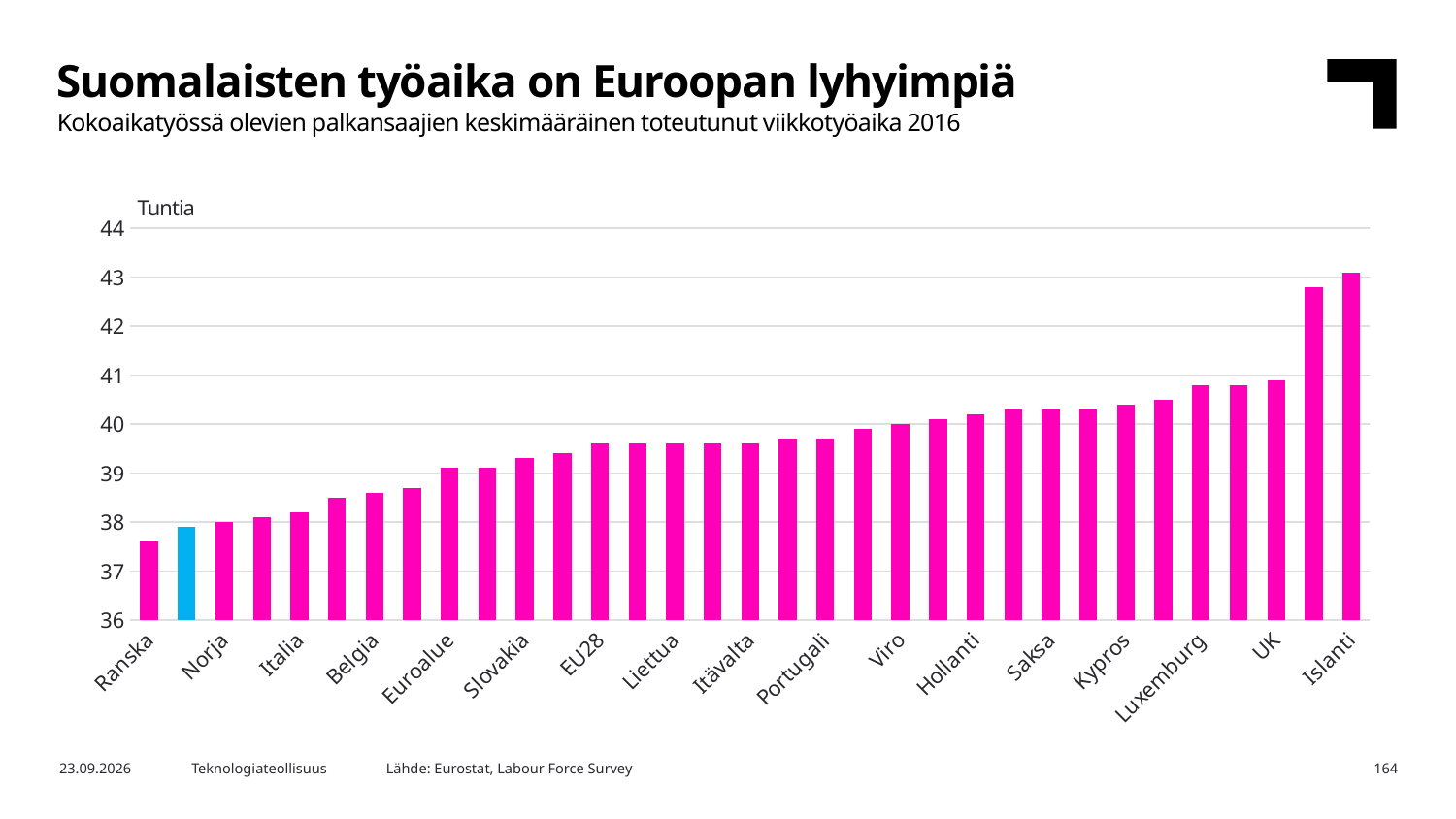
Is the value for Luxemburg greater or less than 40? greater Which has a higher value, Belgia or Luxemburg? Luxemburg Is the value for Ranska greater or less than 38? less Which labelled country has the lowest average weekly working time in the chart? Ranska Which country has the highest average weekly working time in the chart? Islanti Is the value for Islanti greater or less than 42? greater Do the values rise or fall from left to right along the x axis? Rise Which has a higher value, Italia or Saksa? Saksa What kind of chart is shown on the slide? Bar chart What unit is shown on the y axis of the chart? Tuntia